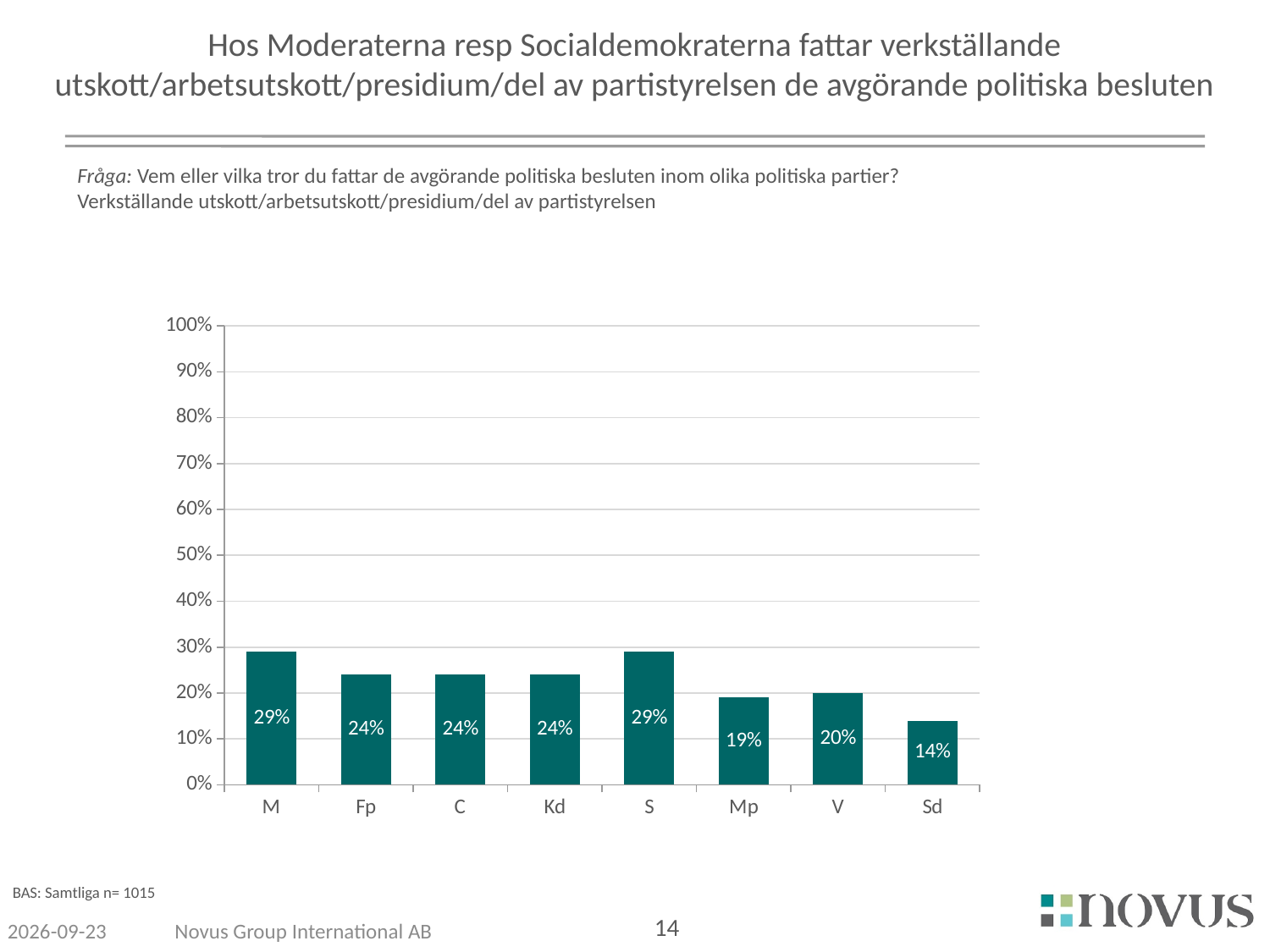
How many categories are shown on the x axis? 8 Which category has the lowest value? Sd What is the difference between the values for M and Sd? 15% Which is larger, the value for V or the value for Sd? V What is the value for Sd? 14% Which is larger, the value for S or the value for Mp? S What is the difference between the values for Fp and V? 4% What is the value for Mp? 19% What kind of chart is shown? bar chart Is the value for Kd greater or less than 30%? less What is the highest value shown on the y axis? 100% What is the value for M? 29%